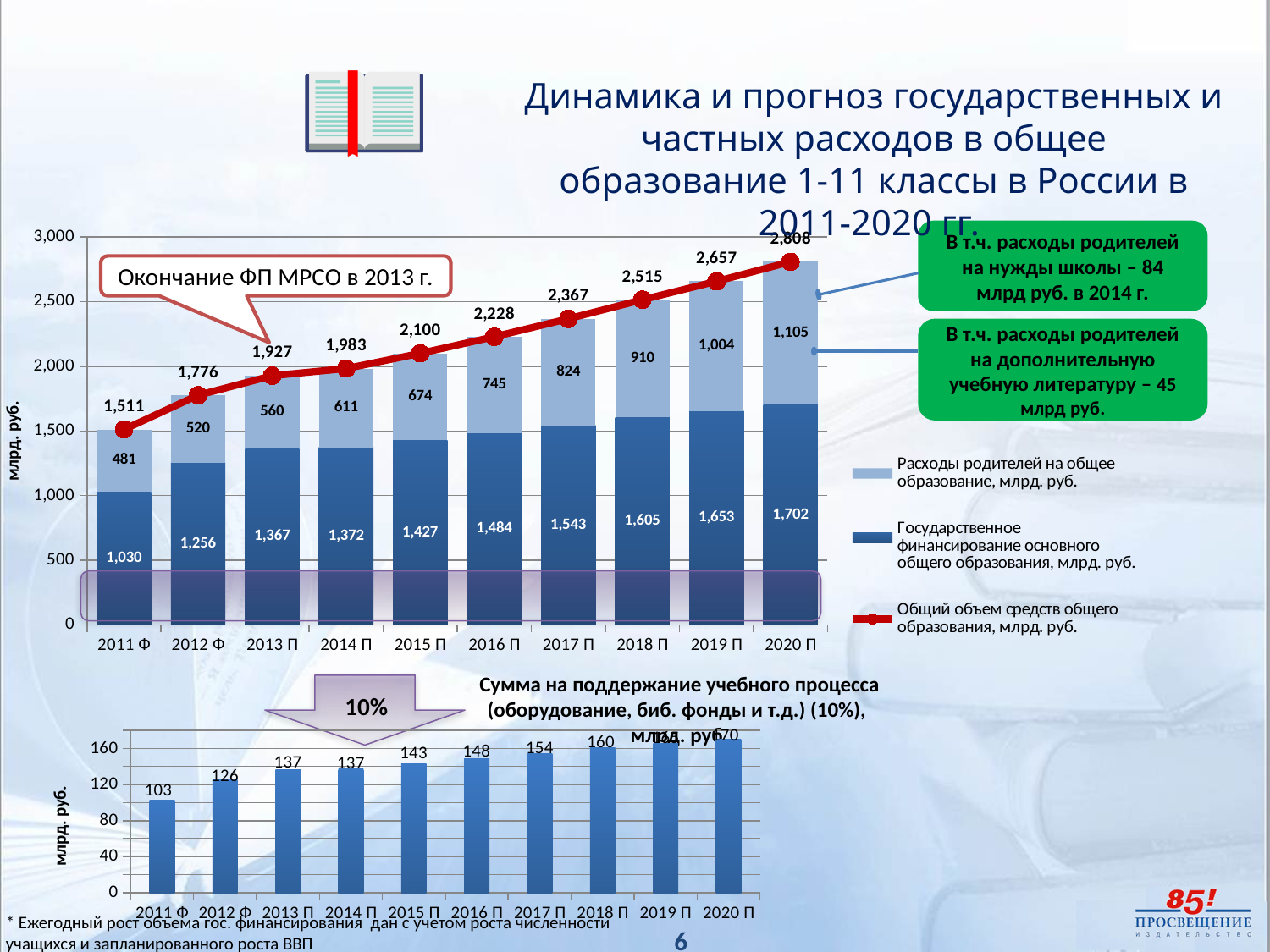
In the top chart, which year has the highest total volume of funds? 2020 П In the top chart, which is larger for 2018 П: government funding or parents' spending? Government funding (1,605) In the top chart, how many years are shown on the x axis? 10 In the top chart, what is the total volume (Общий объем средств) shown for 2015 П? 2,100 In the top chart, what is the value of the government funding series (Государственное финансирование) for 2011 Ф? 1,030 In the top chart, what is the value of the parents' spending series (Расходы родителей) for 2020 П? 1,105 In the bottom chart, which year has the lowest value? 2011 Ф In the bottom chart, what is the value for 2011 Ф? 103 What kind of chart is the bottom chart? Bar chart In the top chart, how many series does the legend list? 3 In the top chart, do the total volume values rise or fall from 2011 Ф to 2020 П? Rise In the top chart, what is the difference between the total volume for 2020 П and 2011 Ф? 1,297